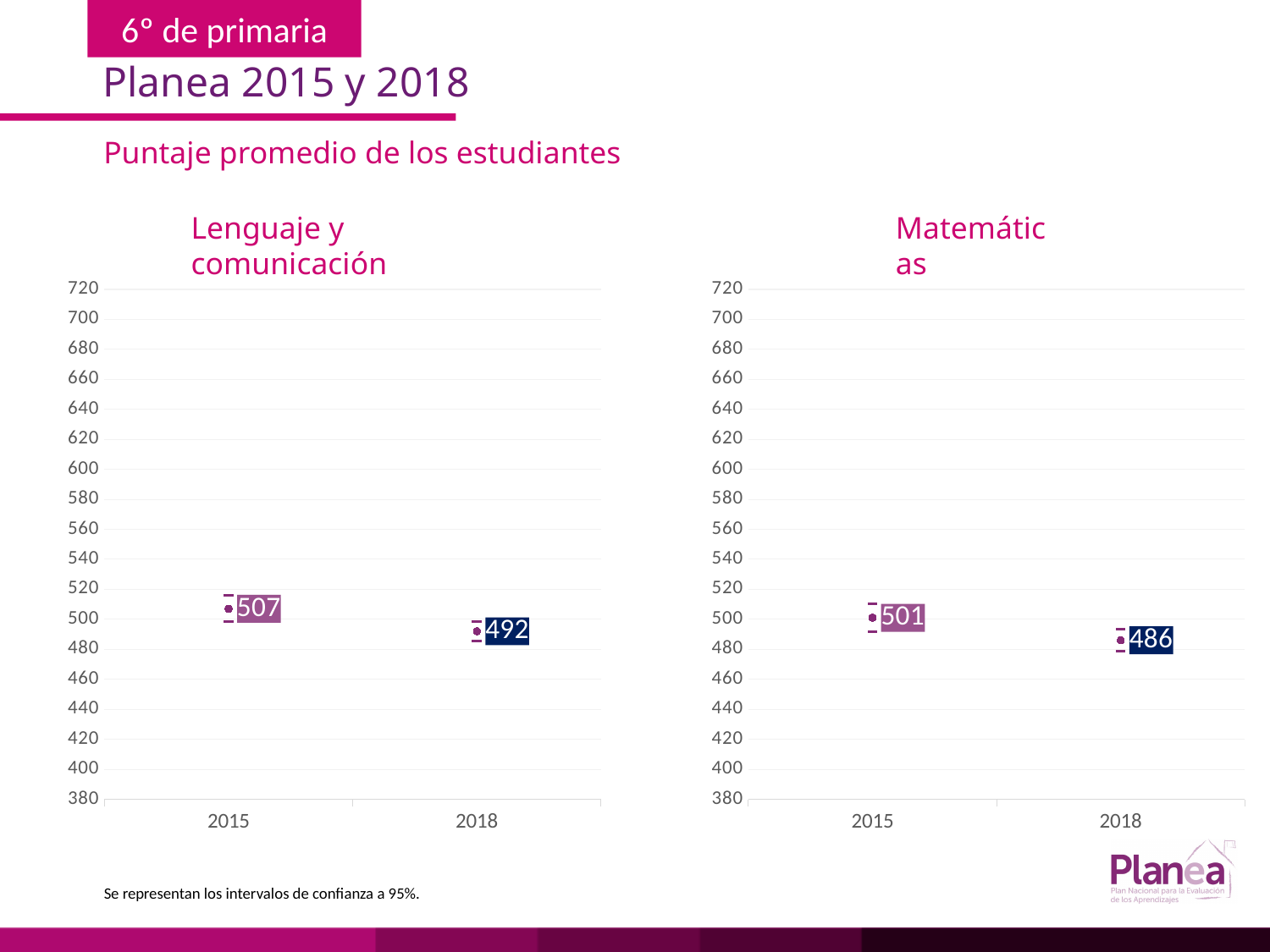
In the 'Lenguaje y comunicación' chart, do the values rise or fall from 2015 to 2018? fall Which is larger: the 2015 value in the 'Lenguaje y comunicación' chart or the 2015 value in the 'Matemáticas' chart? Lenguaje y comunicación (507) How many years are plotted in the 'Matemáticas' chart? 2 In the 'Lenguaje y comunicación' chart, what is the value for 2018? 492 In the 'Matemáticas' chart, what is the value for 2018? 486 In the 'Lenguaje y comunicación' chart, what is the difference between the 2015 and 2018 values? 15 In the 'Matemáticas' chart, which year has the lower value? 2018 In the 'Lenguaje y comunicación' chart, which year has the higher value? 2015 In the 'Matemáticas' chart, what is the value for 2015? 501 In the 'Matemáticas' chart, is the value for 2018 greater or less than 500? less In the 'Matemáticas' chart, what is the difference between the 2015 and 2018 values? 15 In the 'Lenguaje y comunicación' chart, what is the value for 2015? 507